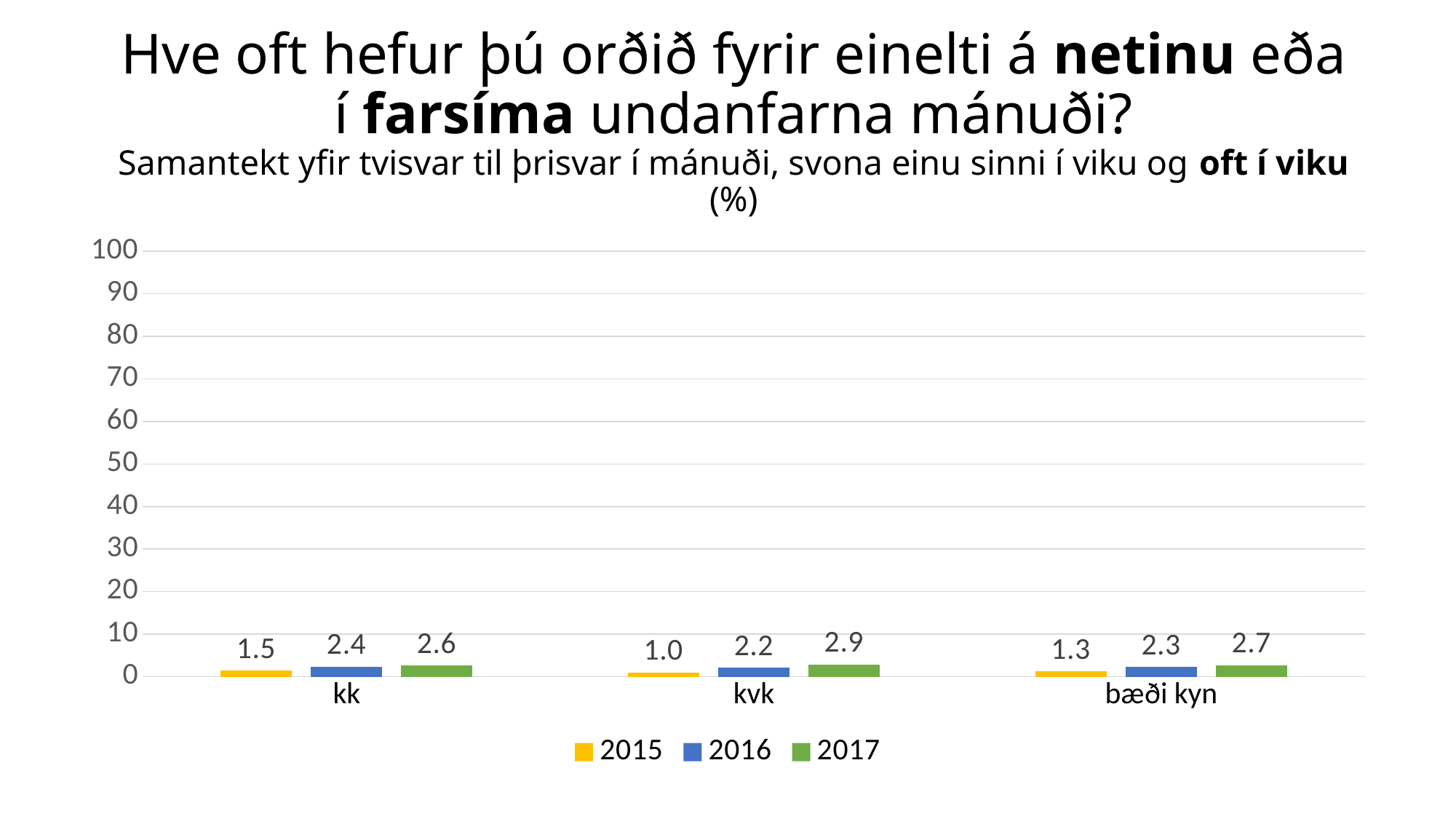
Which is larger for kk: the 2016 value or the 2017 value? 2017 Which category has the highest value in 2017? kvk What is the value for kk in 2015? 1.5 How many categories are shown on the x axis? 3 What is the value for kvk in 2017? 2.9 What kind of chart is shown on the slide? bar chart Is the value for kvk in 2017 greater or less than 10? less Which category has the lowest value in 2015? kvk What is the difference between the 2016 and 2015 values for bæði kyn? 1.0 What is the value for bæði kyn in 2016? 2.3 How many series does the legend list? 3 What is the difference between the 2017 and 2015 values for kvk? 1.9